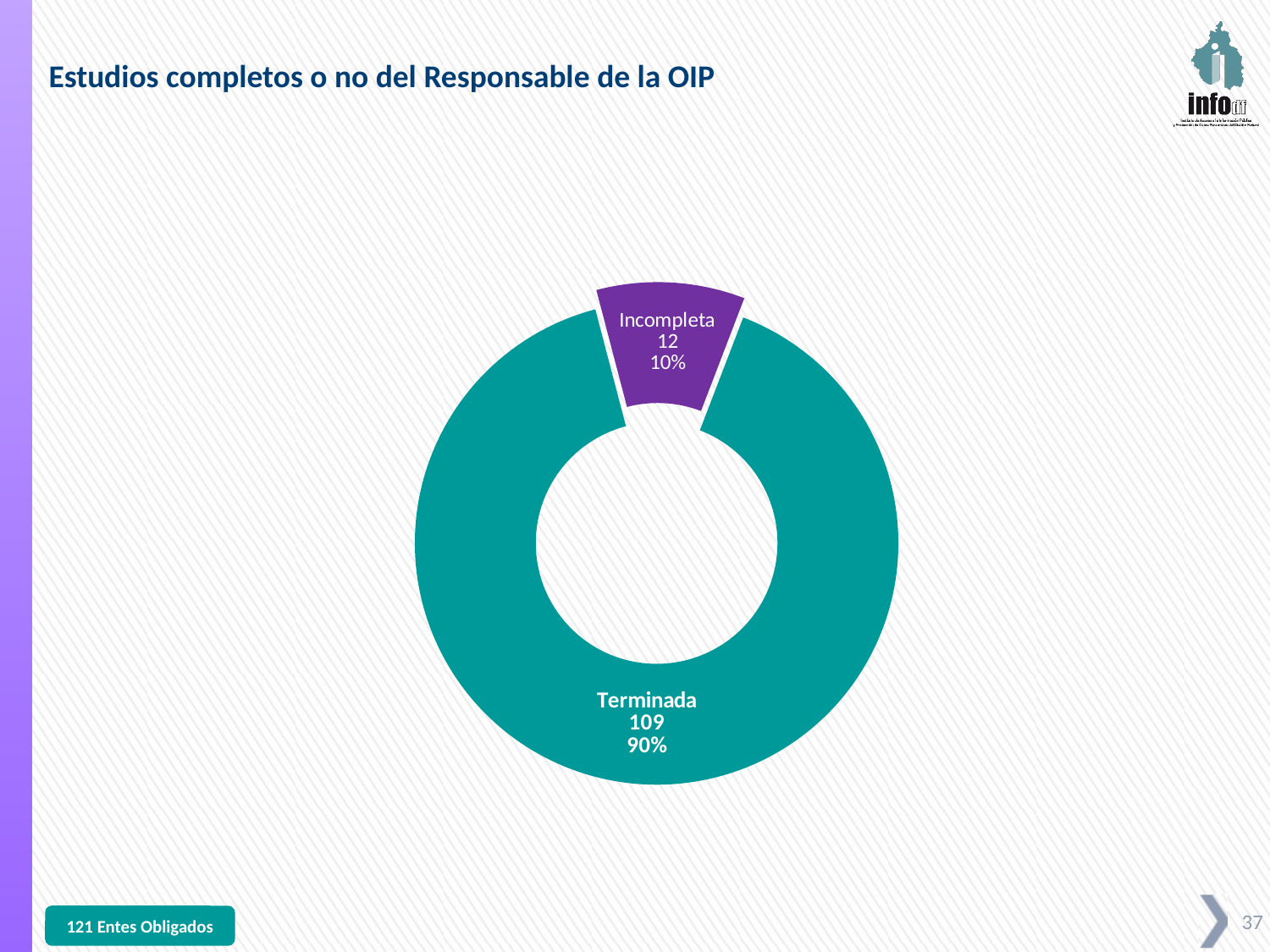
What is the title of the slide? Estudios completos o no del Responsable de la OIP What is the value for Incompleta? 12 What kind of chart is shown on the slide? Doughnut (pie) chart Which category has the largest slice? Terminada How many categories does the chart show? 2 What is the value for Terminada? 109 What percentage share does Incompleta have? 10% Which category has the smallest slice? Incompleta What is the difference between the Terminada and Incompleta values? 97 Which is larger, Terminada or Incompleta? Terminada What is the total of the two slices? 121 What percentage share does Terminada have? 90%